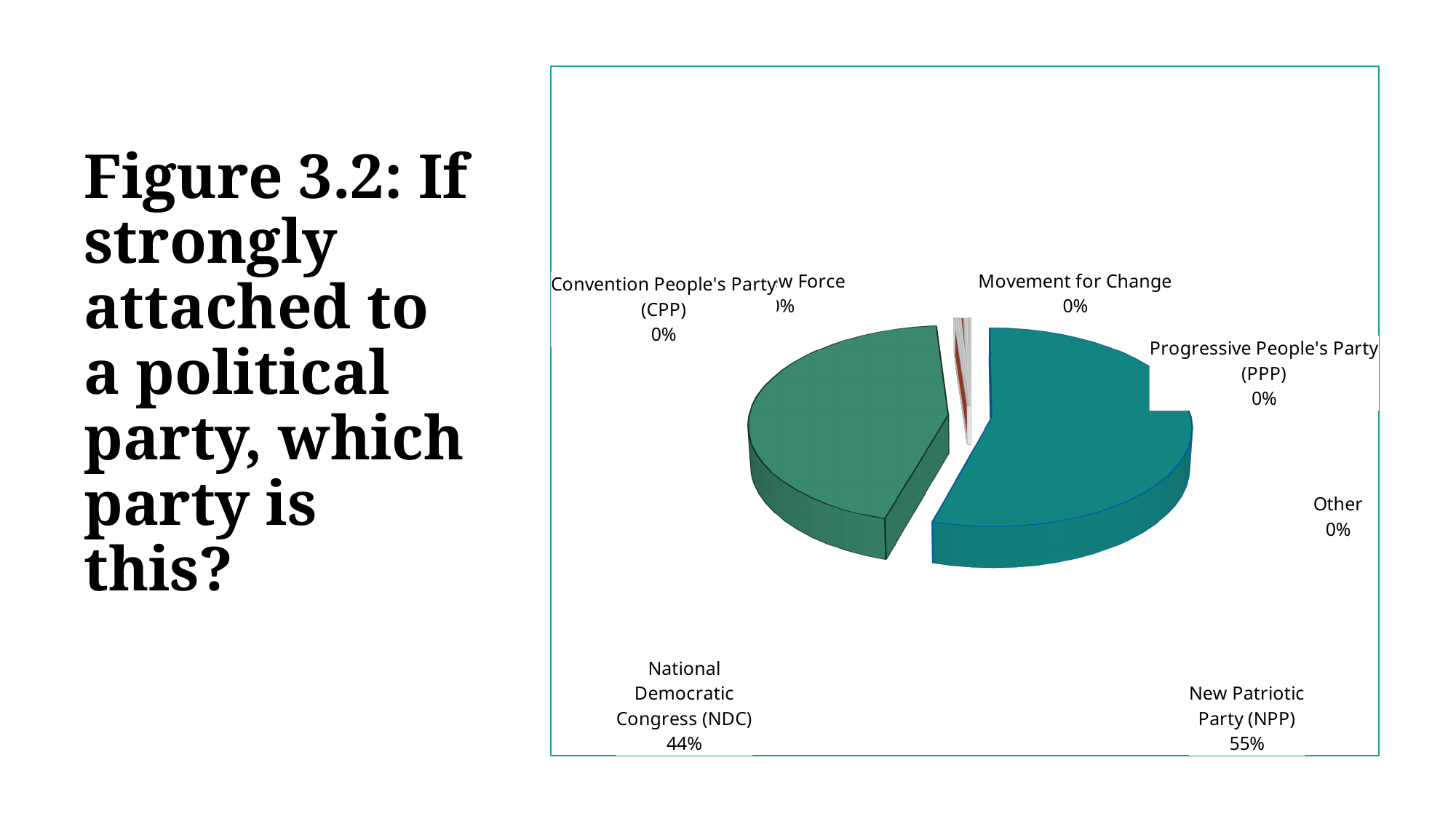
What percentage is shown for the Progressive People's Party (PPP)? 0% What percentage of the pie is labelled for the New Patriotic Party (NPP)? 55% What is the difference in percentage points between the NPP share and the NDC share? 11 percentage points Which party has the largest slice of the pie? New Patriotic Party (NPP) What percentage is shown for Movement for Change? 0% What percentage is shown for the National Democratic Congress (NDC)? 44% What percentage is shown for the 'Other' category? 0% What kind of chart is shown on the slide? Pie chart What percentage is shown for the Convention People's Party (CPP)? 0% What is the figure title given on the slide? Figure 3.2: If strongly attached to a political party, which party is this? Which is larger, the share for the New Patriotic Party (NPP) or the National Democratic Congress (NDC)? New Patriotic Party (NPP) What share of the pie does the National Democratic Congress (NDC) take? 44%